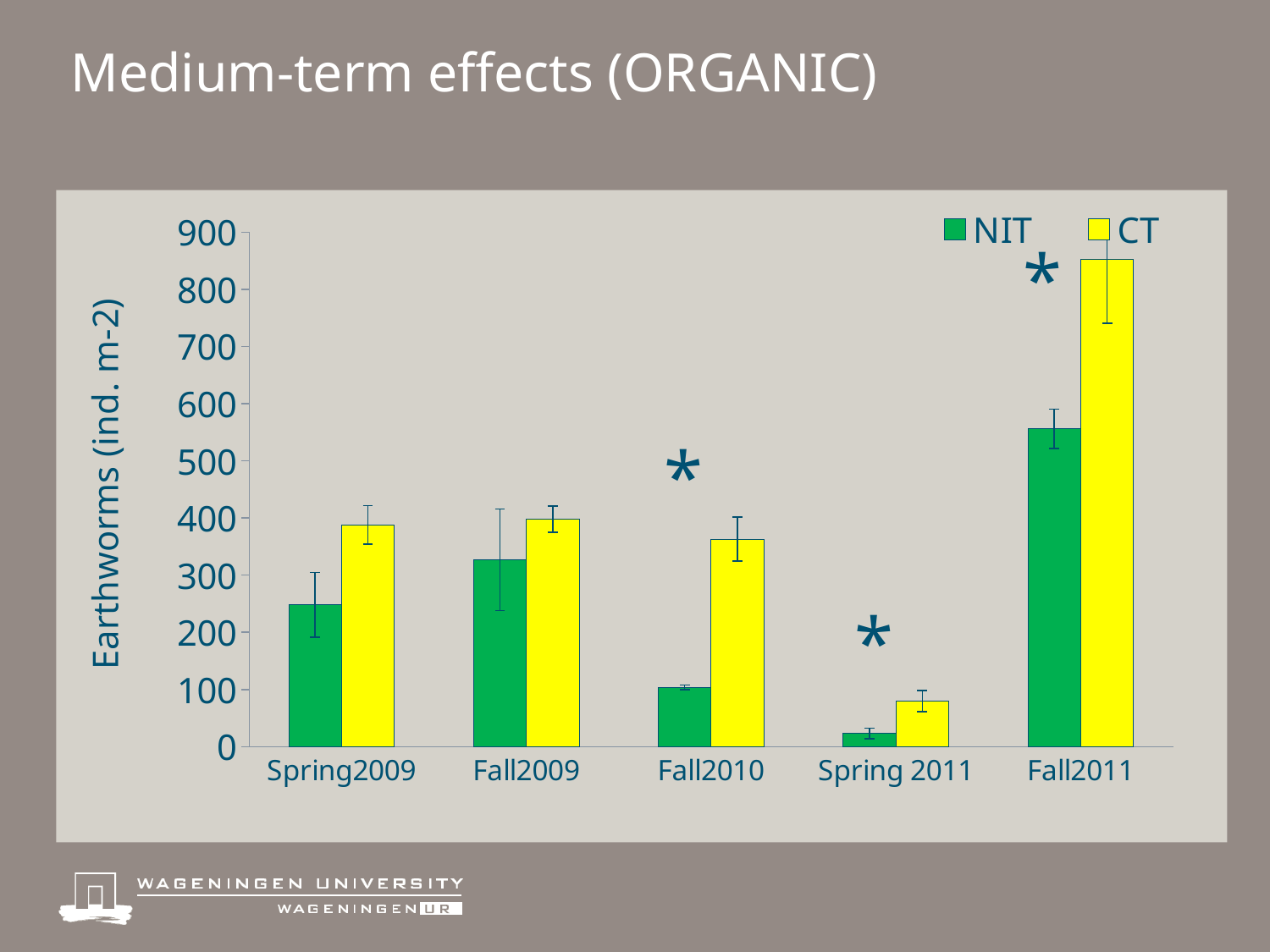
Is the CT value for Spring 2011 greater or less than 100? less How many series does the legend list? 2 Is the CT value for Fall2011 greater or less than 800? greater Is the NIT value for Fall2011 greater or less than 500? greater What is the label of the y axis? Earthworms (ind. m-2) In Fall2010, which is larger, the NIT value or the CT value? CT In which sampling period is the CT value highest? Fall2011 What kind of chart is shown on the slide? bar chart In which sampling period is the NIT value highest? Fall2011 In which sampling period is the NIT value lowest? Spring 2011 How many sampling periods are shown on the x axis? 5